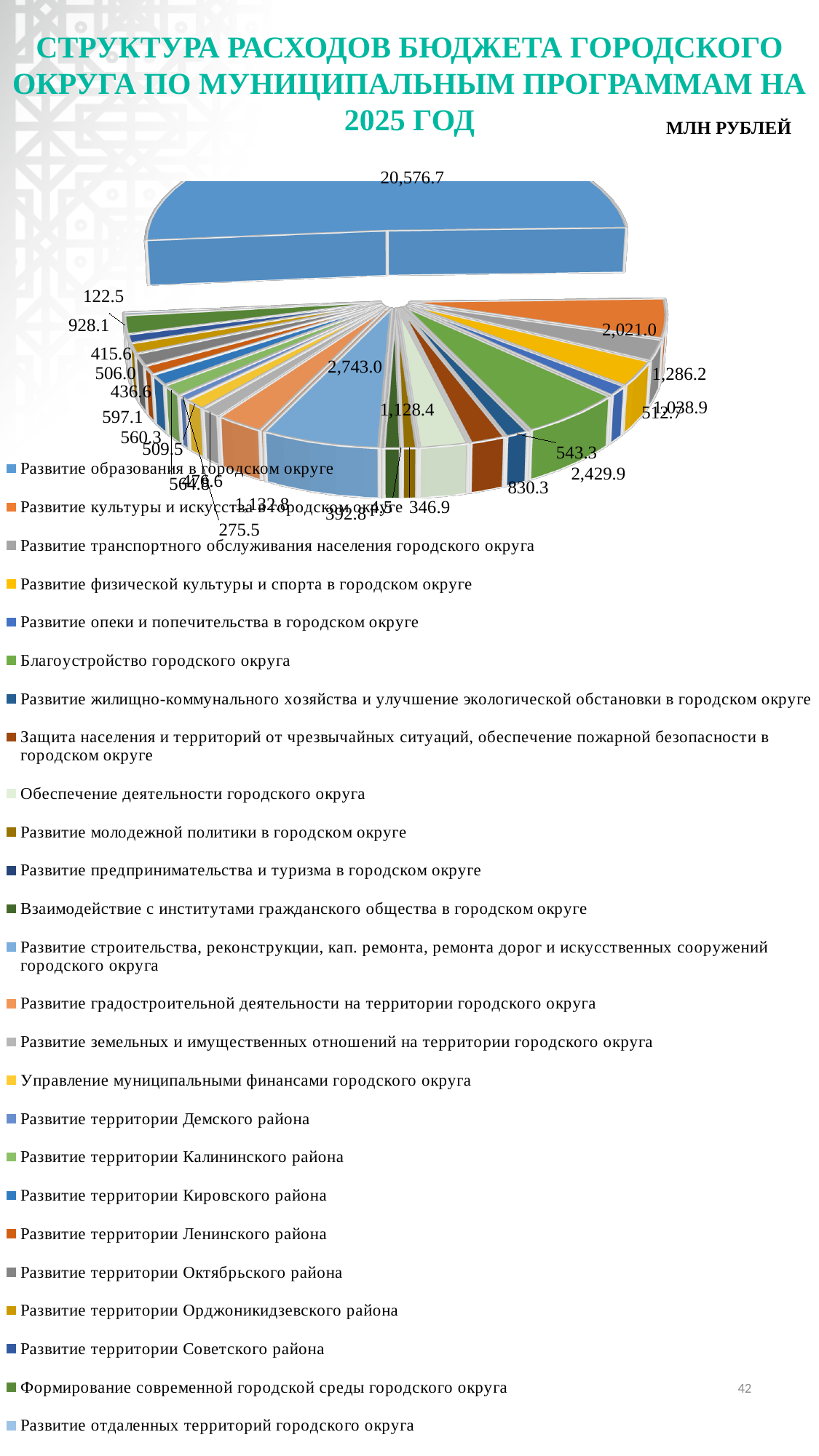
How many entries does the legend of the pie chart list? 25 What kind of chart is shown on the slide? pie chart What is the difference between the value for Развитие образования в городском округе (20,576.7) and the value for Развитие культуры и искусства в городском округе (2,021.0)? 18,555.7 Which municipal program has the largest share of budget expenditures in the pie chart? Развитие образования в городском округе Which is larger: the slice for Развитие образования в городском округе or the slice for Развитие культуры и искусства в городском округе? Развитие образования в городском округе What is the value shown for Благоустройство городского округа (the green slice)? 2,429.9 In what units are the values in the chart expressed, according to the slide? МЛН РУБЛЕЙ What is the value of the largest slice in the pie chart? 20,576.7 What is the value shown for Развитие культуры и искусства в городском округе (the orange slice)? 2,021.0 What year does the chart title refer to? 2025